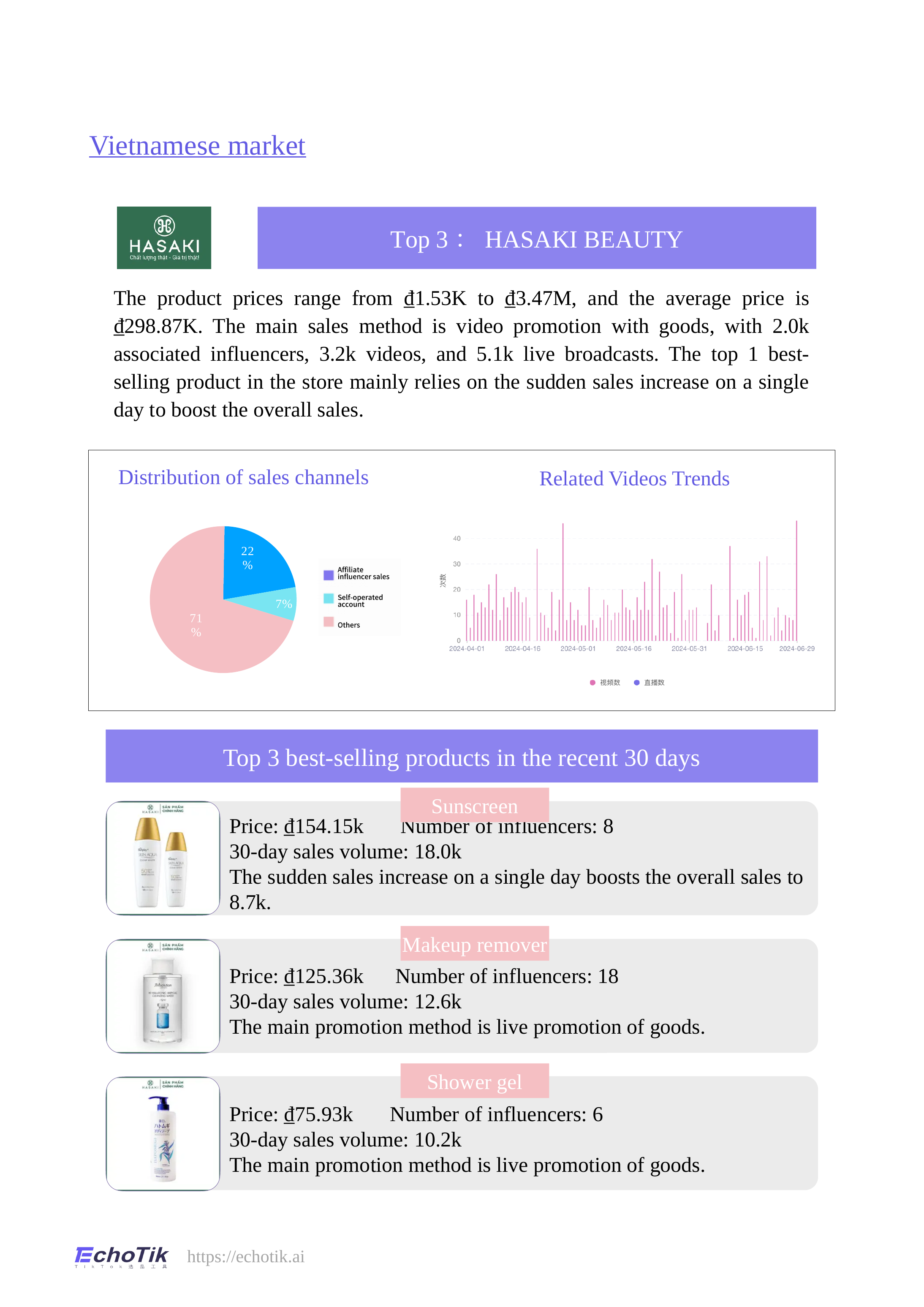
What kind of chart is 'Distribution of sales channels'? Pie chart In the 'Distribution of sales channels' chart, which sales channel has the smallest share? Self-operated account How many slices does the 'Distribution of sales channels' pie chart have? 3 In the 'Distribution of sales channels' chart, what share is 'Affiliate influencer sales'? 22% In the 'Distribution of sales channels' chart, what share of sales channels is 'Others'? 71% In the 'Distribution of sales channels' chart, which sales channel has the largest share? Others In the 'Distribution of sales channels' chart, which is larger: 'Affiliate influencer sales' or 'Self-operated account'? Affiliate influencer sales In the 'Distribution of sales channels' chart, what share is 'Self-operated account'? 7% In the 'Distribution of sales channels' chart, what is the difference in percentage points between 'Others' and 'Affiliate influencer sales'? 49 What kind of chart is 'Related Videos Trends'? Bar chart How many series does the legend of the 'Related Videos Trends' chart list? 2 In the 'Related Videos Trends' chart, is the value at 2024-06-29 greater or less than 40? greater